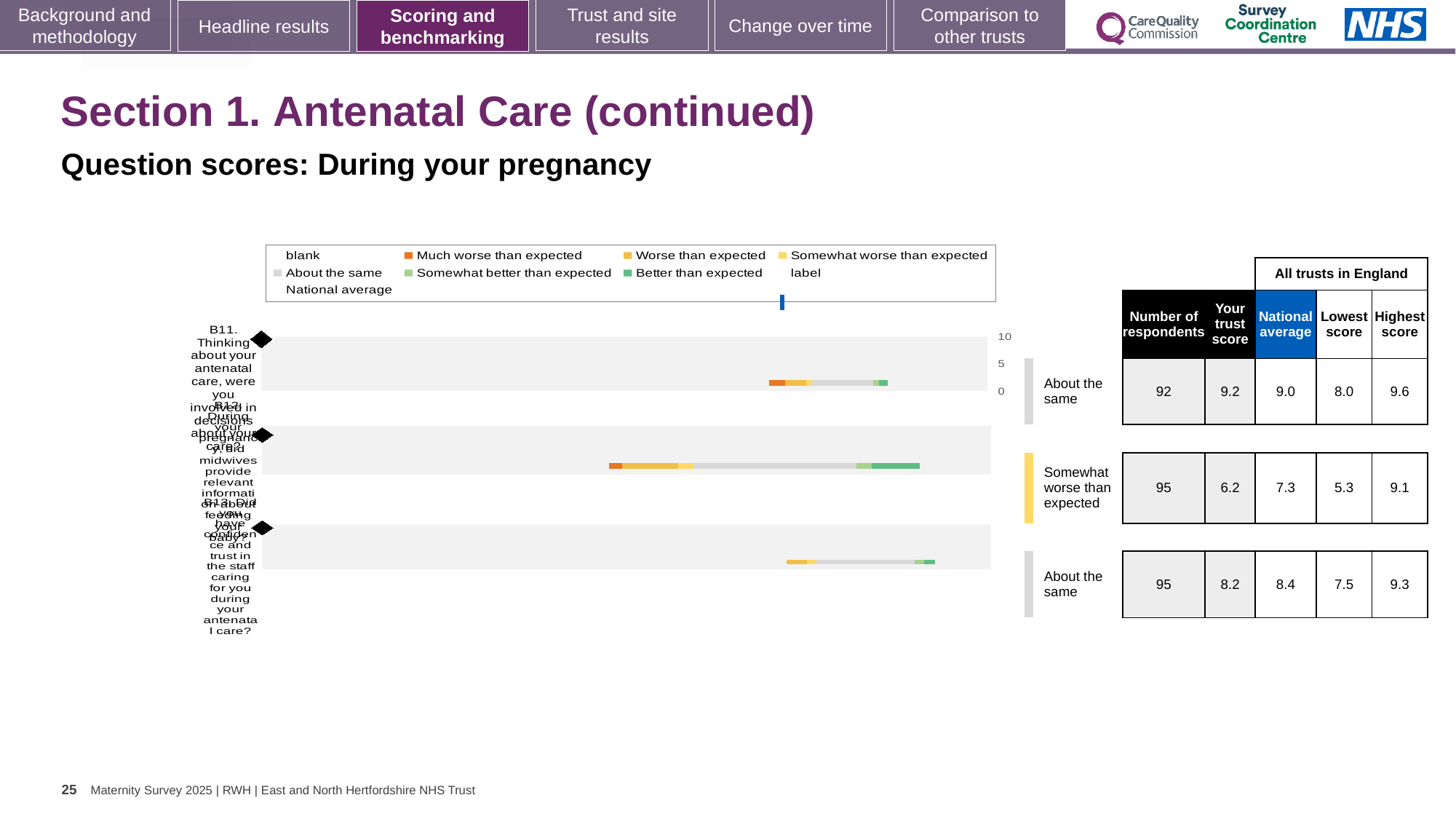
What is the national average for B12 (midwives provide relevant information about feeding your baby)? 7.3 Which question has the highest trust score? B11 What is the highest score among all trusts in England for B11? 9.6 How many entries does the chart legend list? 9 What benchmark category is shown for B12? Somewhat worse than expected Which question has the lowest trust score? B12 How many questions (categories) are plotted in the chart? 3 What is the trust score for B11 (involved in decisions about your antenatal care)? 9.2 How many respondents answered B13 (confidence and trust in the staff caring for you)? 95 For B12, how much lower is the trust score than the national average? 1.1 What kind of chart is shown on the slide? Bar chart For B13, which is larger: the trust score or the national average? National average